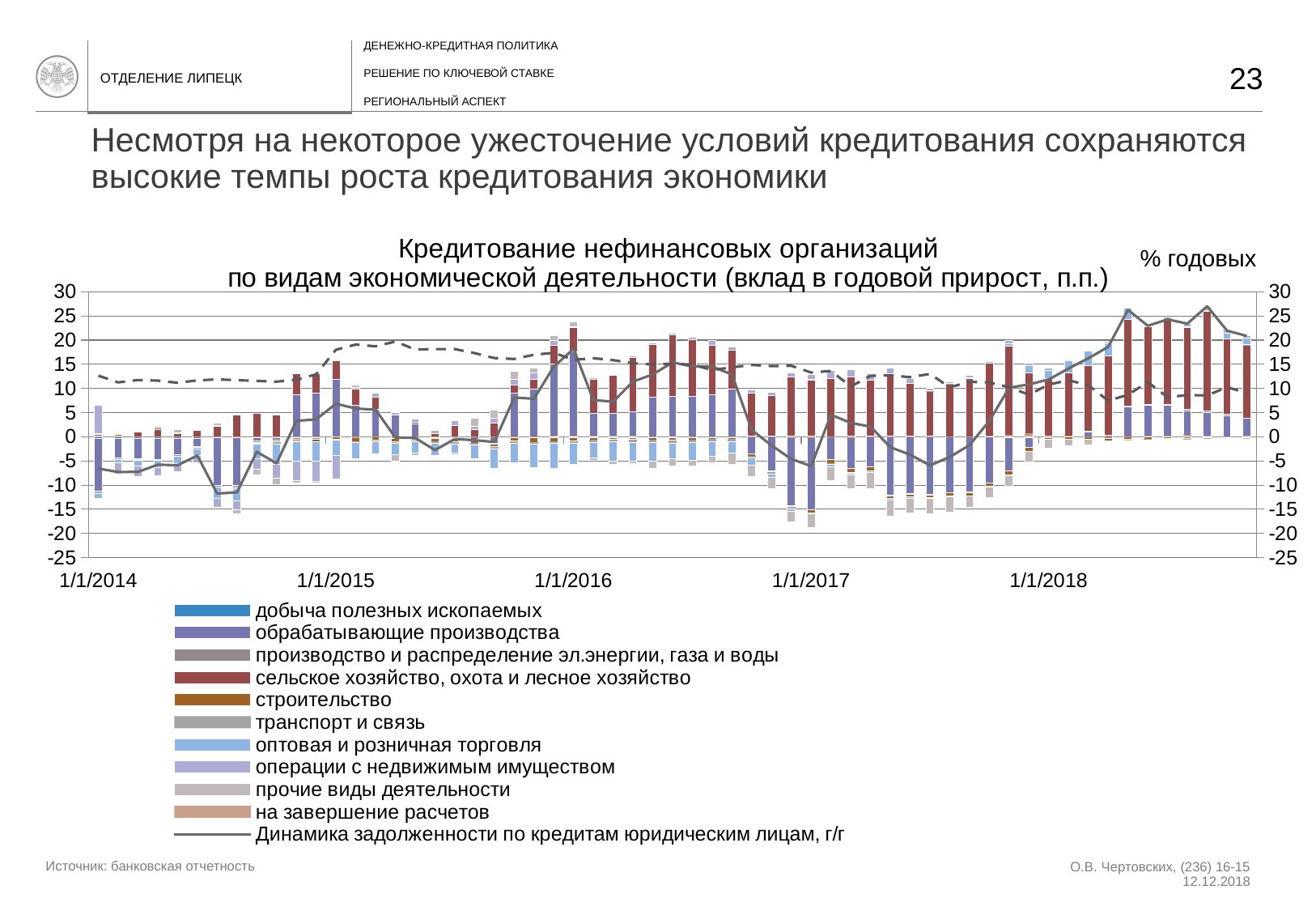
Does the line 'Динамика задолженности по кредитам юридическим лицам, г/г' rise or fall between 1/1/2017 and 1/1/2018? rise What is the title of the chart? Кредитование нефинансовых организаций по видам экономической деятельности (вклад в годовой прирост, п.п.) Is the highest value reached by the line 'Динамика задолженности по кредитам юридическим лицам, г/г' greater or less than 20? greater What unit is shown at the top right of the chart? % годовых Is the value of the line 'Динамика задолженности по кредитам юридическим лицам, г/г' at 1/1/2016 greater or less than 10? greater Is the value of the line 'Динамика задолженности по кредитам юридическим лицам, г/г' at 1/1/2014 greater or less than 0? less How many date labels are shown on the x axis? 5 What kind of chart is shown on the slide? Stacked bar chart with a line Which is larger: the value of the line 'Динамика задолженности по кредитам юридическим лицам, г/г' at 1/1/2016 or at 1/1/2017? 1/1/2016 What is the maximum value shown on the left vertical axis? 30 How many entries does the legend list? 11